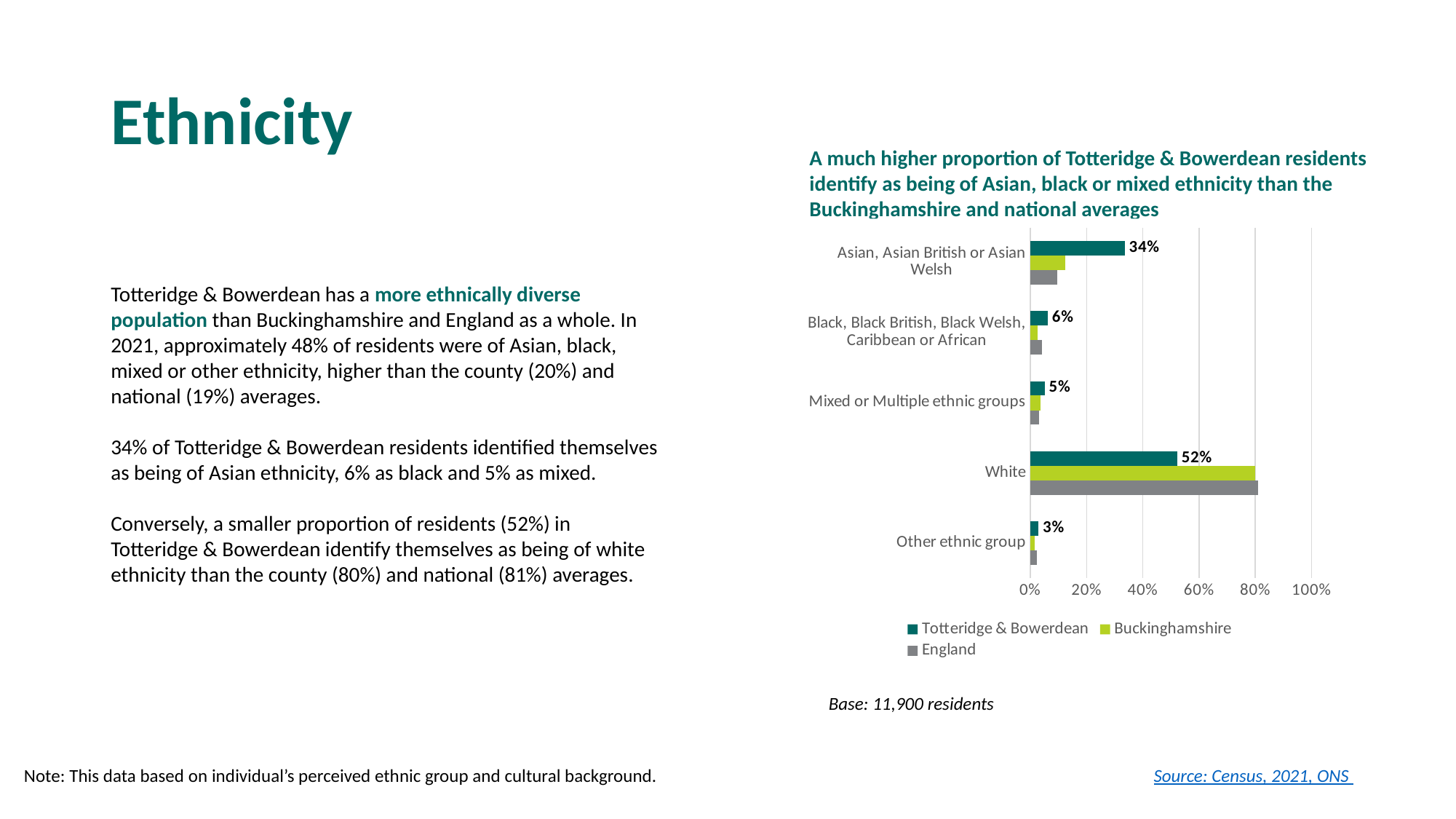
Is the England value for Asian, Asian British or Asian Welsh greater or less than 20%? less What percentage of Totteridge & Bowerdean residents identify as White according to the chart? 52% Which ethnic group has the lowest value for Totteridge & Bowerdean? Other ethnic group What is the Totteridge & Bowerdean value for Asian, Asian British or Asian Welsh? 34% What is the difference between the Totteridge & Bowerdean values for White and for Asian, Asian British or Asian Welsh? 18% For Totteridge & Bowerdean, which is larger: the Black, Black British, Black Welsh, Caribbean or African value or the Mixed or Multiple ethnic groups value? Black, Black British, Black Welsh, Caribbean or African Is the Buckinghamshire value for White greater or less than 60%? greater What is the Totteridge & Bowerdean value for Other ethnic group? 3% How many series does the chart legend list? 3 What type of chart is shown on the slide? Bar chart How many ethnic group categories are shown on the chart? 5 Which ethnic group has the highest value for Totteridge & Bowerdean? White